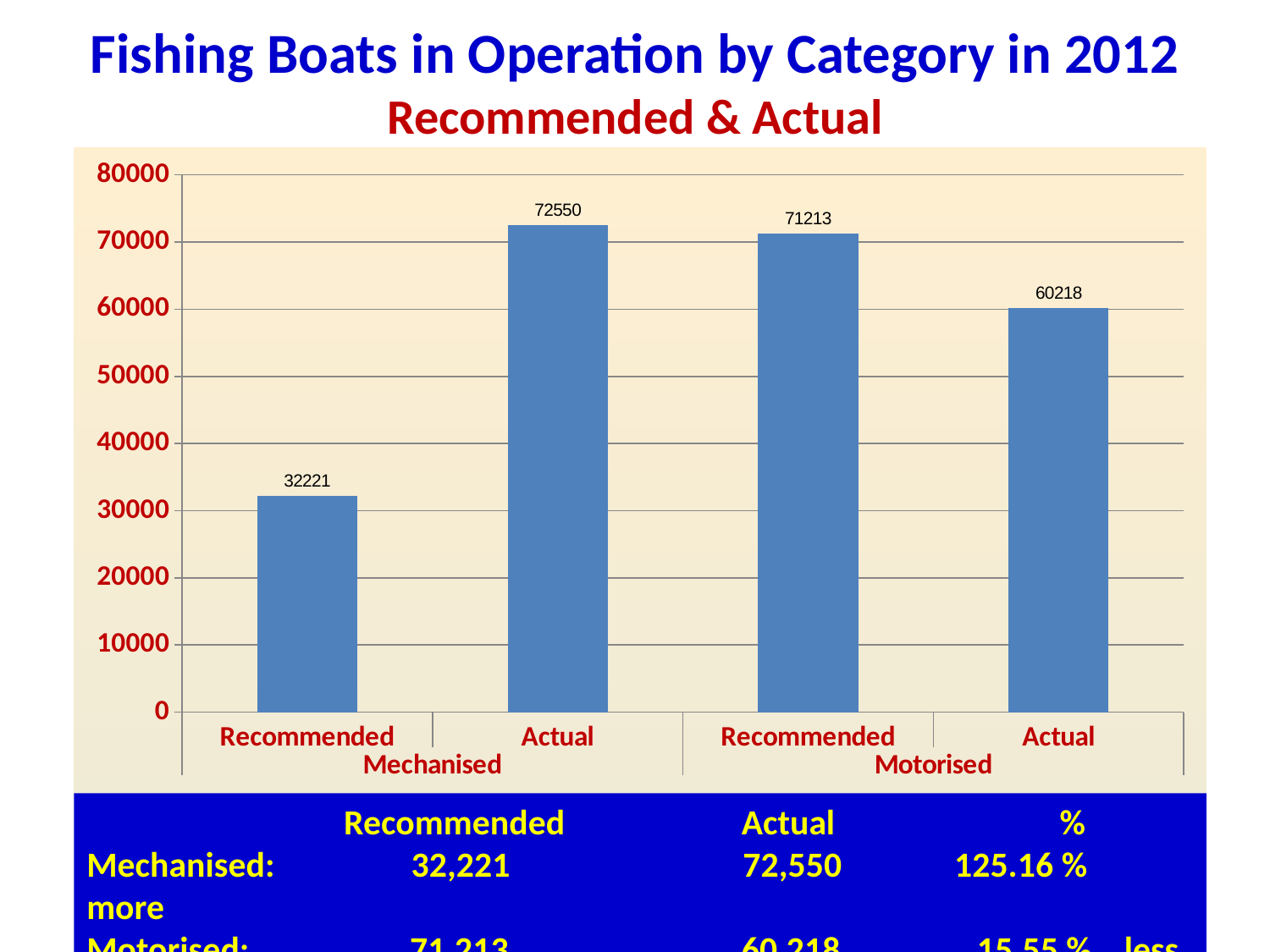
Which bar has the lowest value? Recommended (Mechanised) What is the difference between the Recommended and Actual values for Motorised boats? 10995 Which bar has the highest value? Actual (Mechanised) What is the difference between the Actual and Recommended values for Mechanised boats? 40329 Is the Recommended value for Mechanised boats greater or less than 40000? less What is the value of the Actual bar for Mechanised boats? 72550 What kind of chart is shown on the slide? Bar chart What is the value of the Recommended bar for Mechanised boats? 32221 Which is larger, the Recommended value for Motorised boats or the Actual value for Motorised boats? Recommended (Motorised) What is the value of the Actual bar for Motorised boats? 60218 What is the value of the Recommended bar for Motorised boats? 71213 How many bars are plotted in the chart? 4